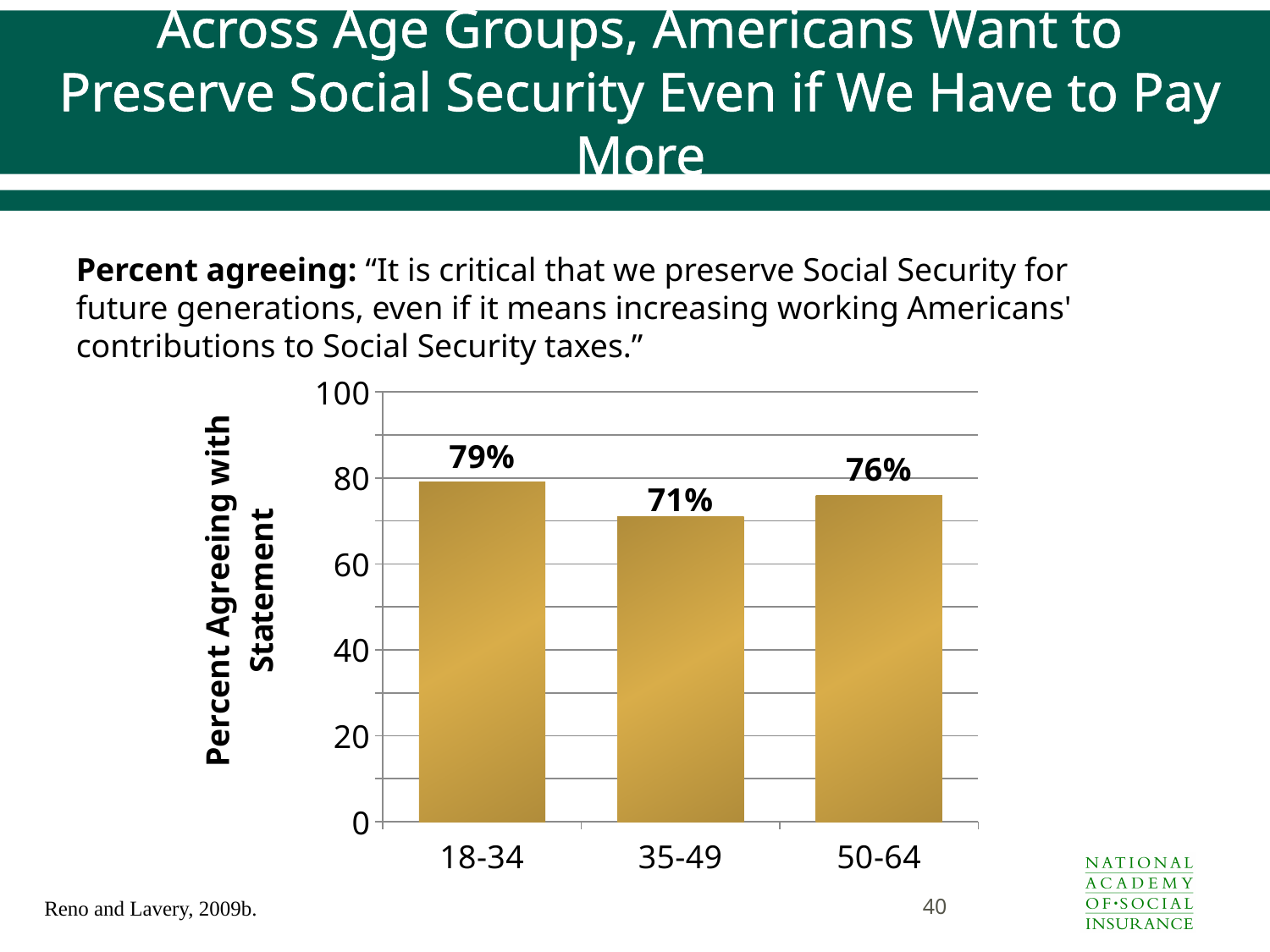
What percent of the 18-34 age group agrees with the statement? 79% What percent of the 35-49 age group agrees with the statement? 71% What is the difference in percent agreeing between the 18-34 and 35-49 age groups? 8 percentage points Which age group has the highest percent agreeing with the statement? 18-34 What kind of chart is shown on the slide? Bar chart How many age groups are shown in the chart? 3 Is the value for the 35-49 age group greater or less than 80? less What is the label of the vertical axis of the chart? Percent Agreeing with Statement What percent of the 50-64 age group agrees with the statement? 76% Which age group has a higher percent agreeing: 18-34 or 50-64? 18-34 What is the difference in percent agreeing between the 50-64 and 35-49 age groups? 5 percentage points Which age group has the lowest percent agreeing with the statement? 35-49